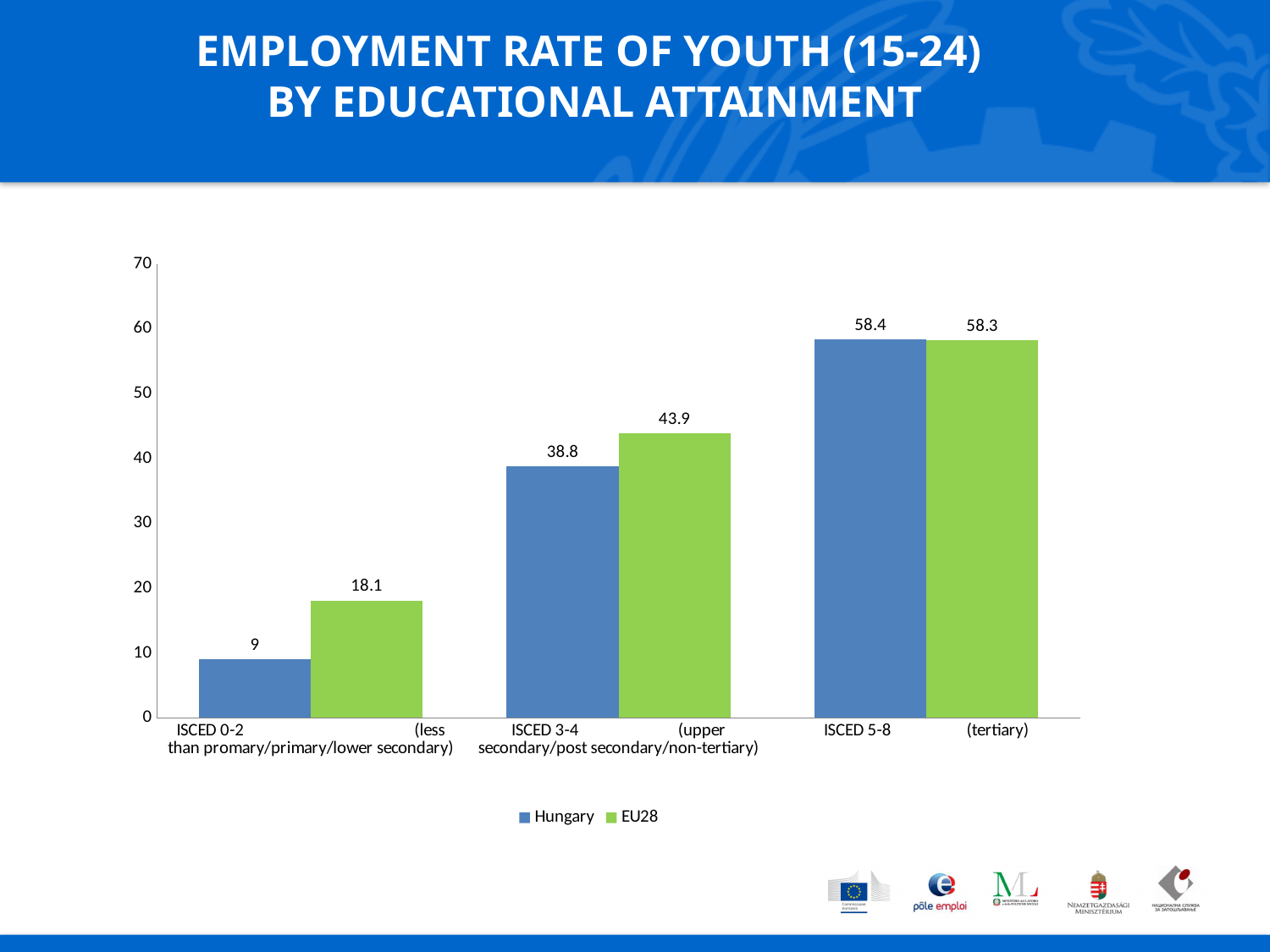
In the ISCED 3-4 category, which series has the larger employment rate, Hungary or EU28? EU28 What is the employment rate for EU28 in the ISCED 3-4 category? 43.9 Is the Hungary value for ISCED 3-4 greater or less than 40? less How many educational attainment categories are shown on the x axis? 3 What is the difference between the EU28 and Hungary employment rates in the ISCED 0-2 category? 9.1 Which educational attainment category has the highest employment rate for Hungary? ISCED 5-8 (tertiary) How many series does the legend list? 2 What is the employment rate for Hungary in the ISCED 0-2 category? 9 What kind of chart is shown on the slide? Bar chart What is the employment rate for Hungary in the ISCED 5-8 (tertiary) category? 58.4 Which educational attainment category has the lowest employment rate for EU28? ISCED 0-2 What is the difference between the EU28 and Hungary employment rates in the ISCED 3-4 category? 5.1